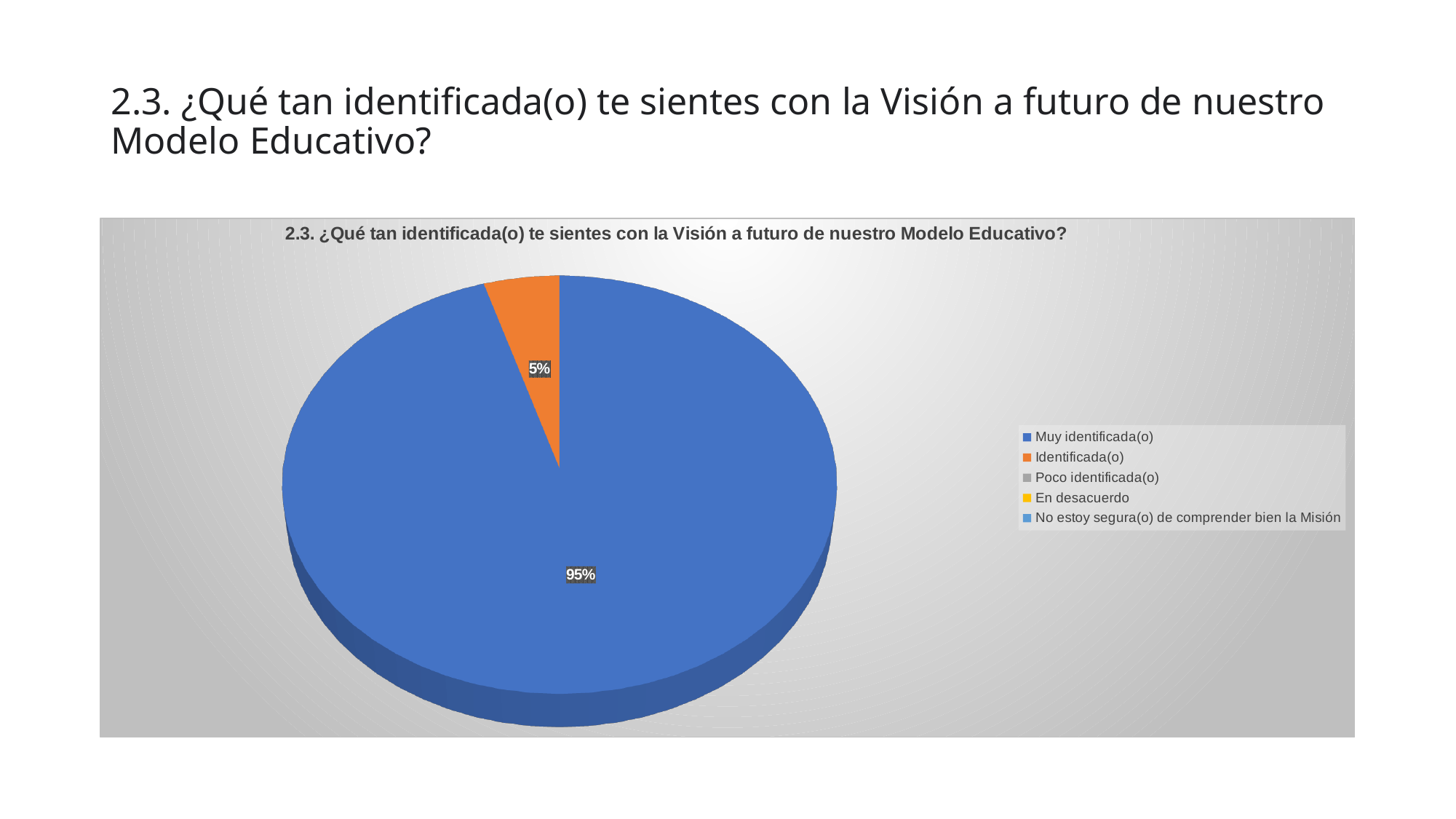
What is the title of the chart? 2.3. ¿Qué tan identificada(o) te sientes con la Visión a futuro de nuestro Modelo Educativo? What type of chart is shown on the slide? Pie chart What colour is the slice for "Identificada(o)"? Orange What is the difference in percentage points between the "Muy identificada(o)" and "Identificada(o)" slices? 90 Which response category has the largest share of the pie? Muy identificada(o) Which of the two labelled slices is larger, "Muy identificada(o)" or "Identificada(o)"? Muy identificada(o) How many entries does the legend list? 5 What percentage of respondents answered "Muy identificada(o)"? 95% How many slices with data labels are visible in the pie? 2 What percentage of respondents answered "Identificada(o)"? 5% What share of the pie does the "Muy identificada(o)" slice represent? 95%